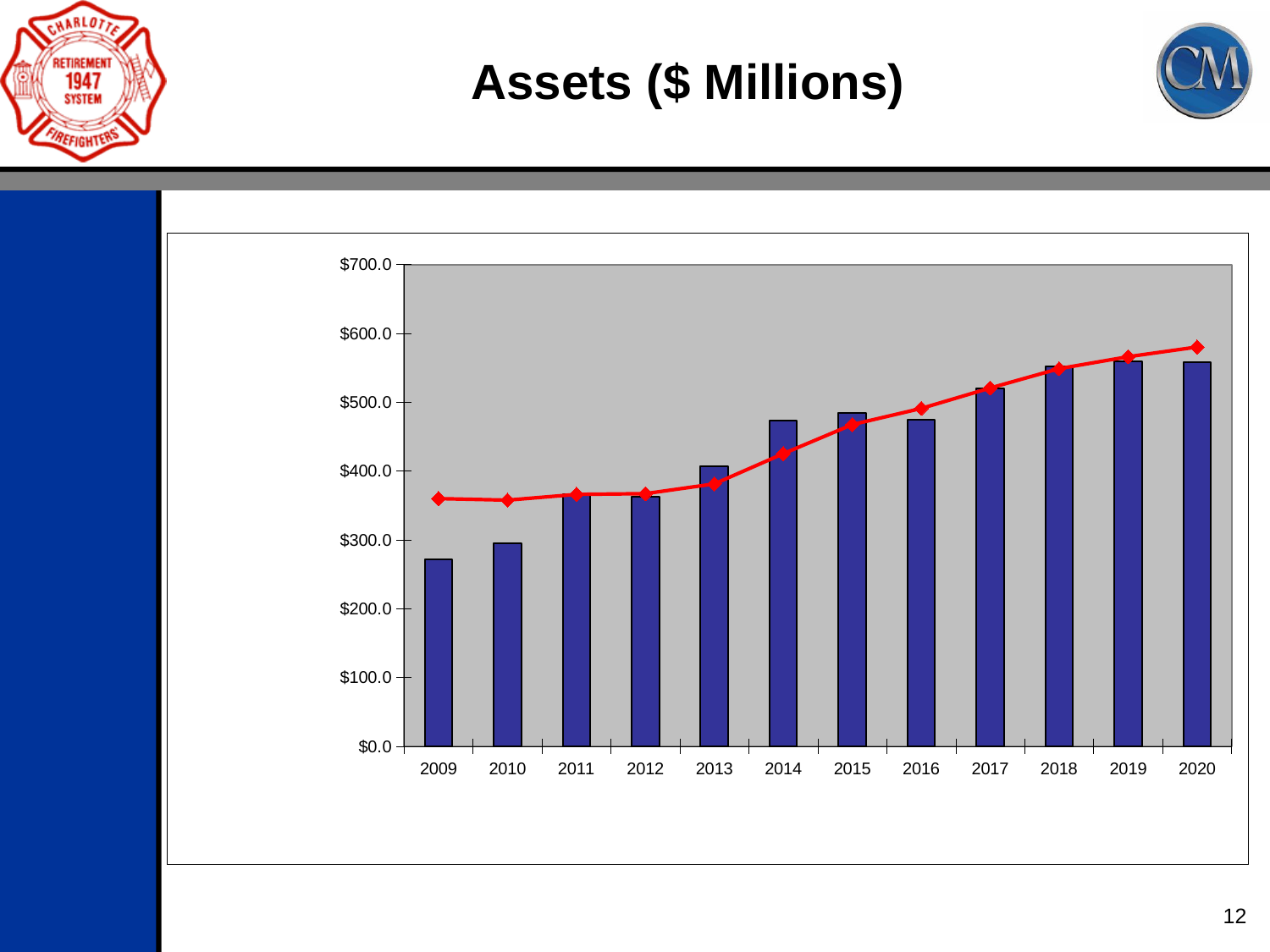
Is the bar value for 2018 greater or less than $500.0? greater What is the title of the chart on the slide? Assets ($ Millions) Is the bar value for 2009 greater or less than $300.0? less Which year has the taller bar, 2013 or 2014? 2014 Do the bar values generally rise or fall from 2009 to 2020? rise Is the bar value for 2016 greater or less than $500.0? less What kind of chart is shown on the slide? A bar chart with a line overlay In which year does the red line reach its highest point? 2020 Which year has the lowest bar in the chart? 2009 How many years are shown on the x axis of the chart? 12